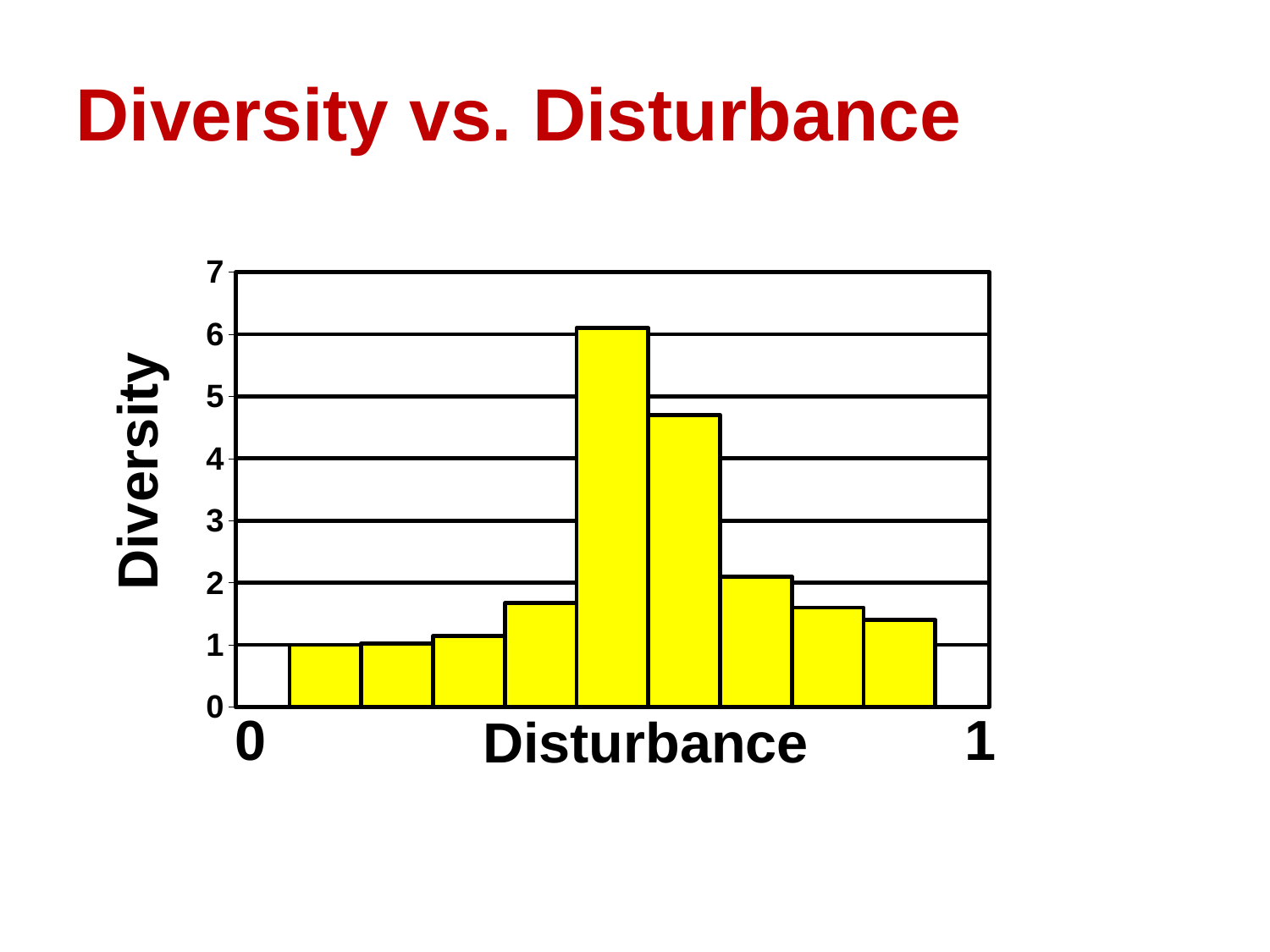
Which bar is the tallest in the chart? the fifth bar from the left Which is taller, the sixth bar from the left or the seventh bar from the left? the sixth bar from the left Is the value of the fourth bar from the left greater or less than 2? less Is the value of the seventh bar from the left greater or less than 3? less Is the value of the sixth bar from the left greater or less than 4? greater What is the label on the x axis of the chart? Disturbance What is the label on the y axis of the chart? Diversity Do the bar heights rise or fall from the fifth bar to the ninth bar along the x axis? fall How many bars are plotted in the chart? 9 What kind of chart is shown on the slide? bar chart